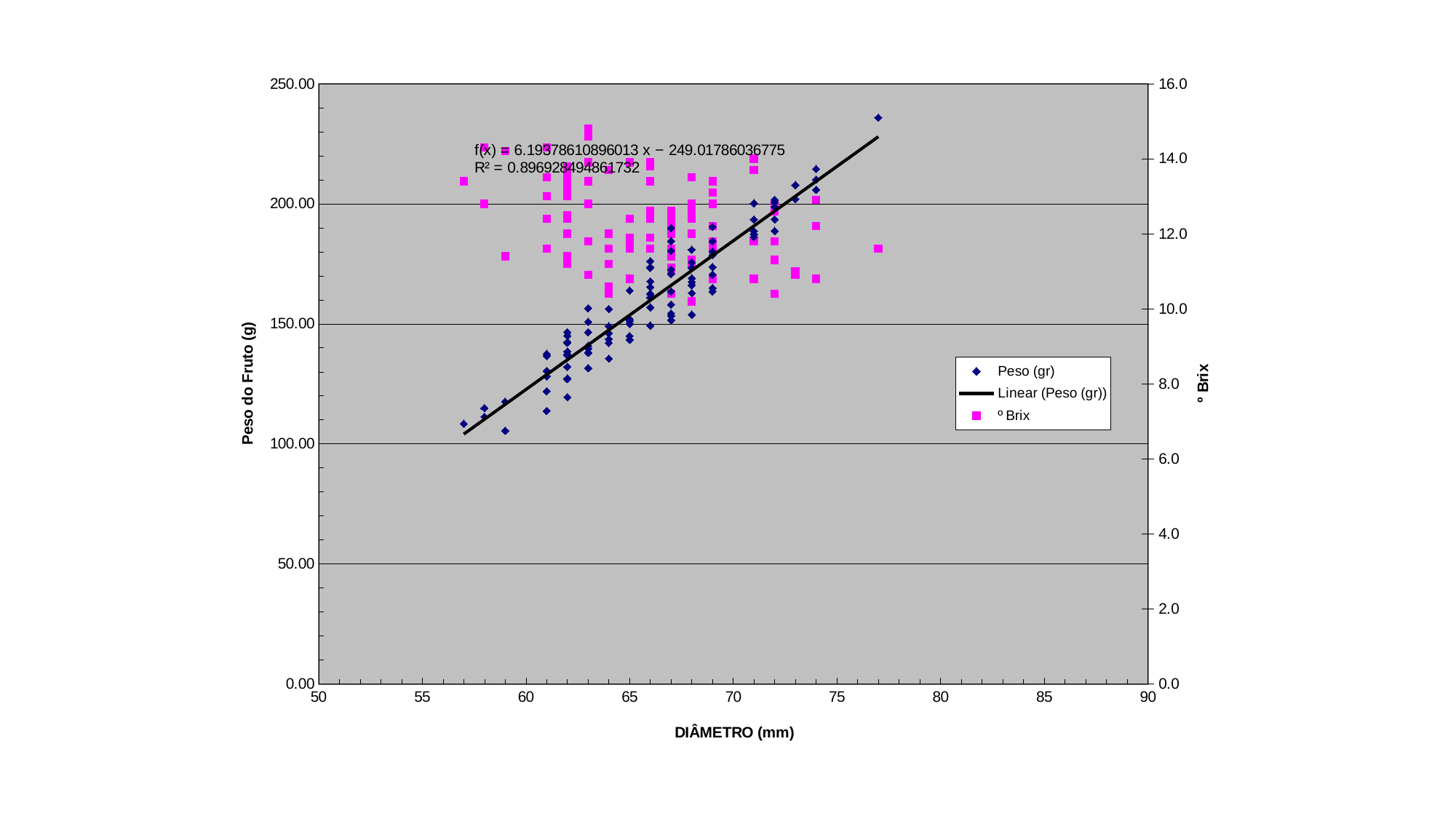
How many entries does the legend list? 3 What kind of chart is shown on the slide? Scatter chart Is the Peso (gr) value at a diameter of 77 mm greater or less than 200? greater What is the maximum value shown on the right y axis (º Brix)? 16.0 What is the maximum value shown on the left y axis (Peso do Fruto)? 250.00 At which diameter does the highest Peso (gr) point occur? 77 What is the title of the x axis? DIÂMETRO (mm) What are the names of the series listed in the legend? Peso (gr), Linear (Peso (gr)), º Brix Does the Peso (gr) series rise or fall as diameter increases along the x axis? Rise Is the º Brix value at a diameter of 57 mm greater or less than 12.0? greater What is the R² value shown on the chart? 0.896928494861732 What is the equation of the linear trendline shown on the chart? f(x) = 6.19378610896013 x − 249.01786036775